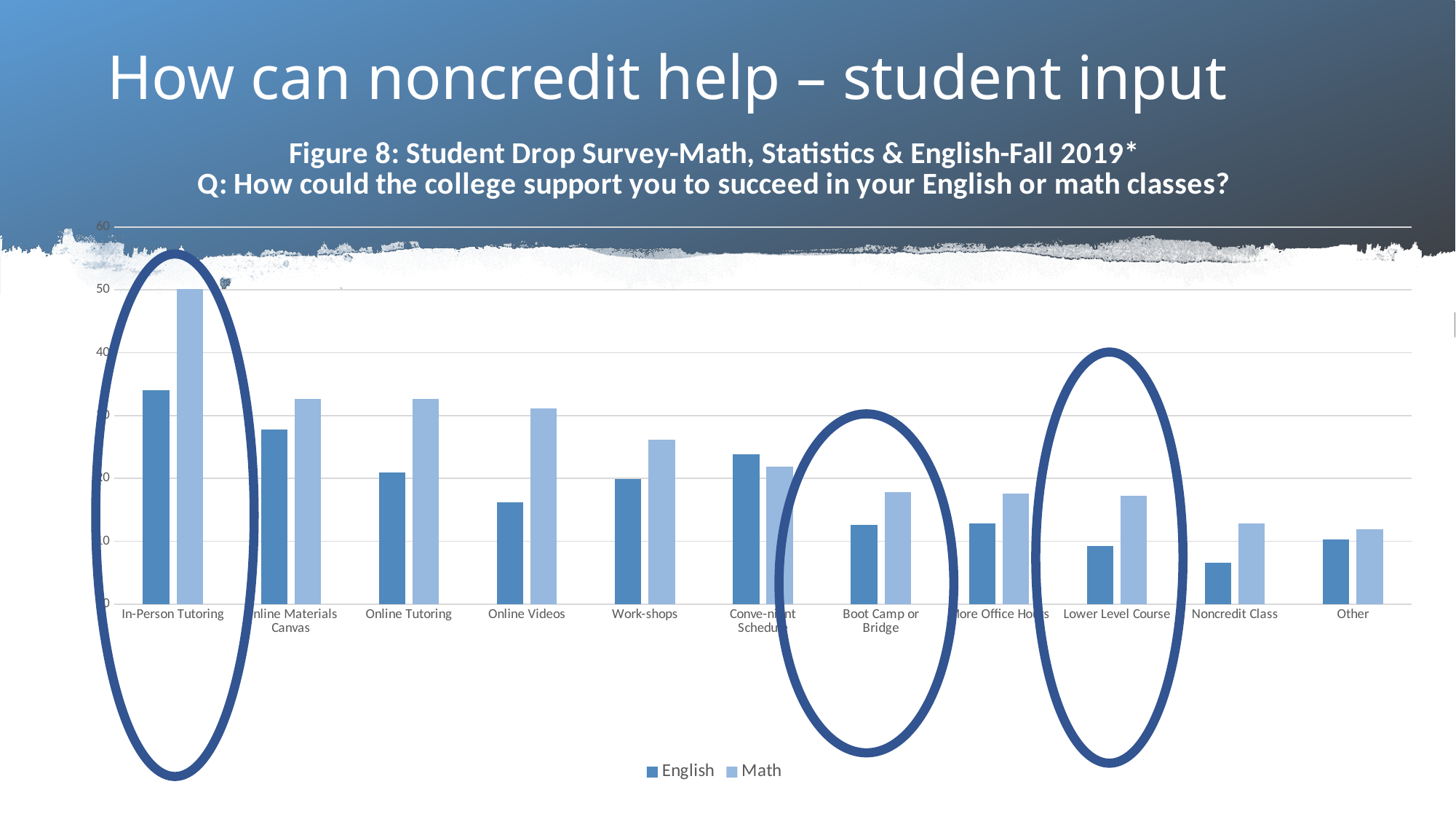
How many series does the legend list? 2 For Online Videos, which series has the larger value, English or Math? Math Is the Math value for Online Tutoring greater or less than 30? greater Which category has the lowest English value? Noncredit Class Is the Math value for Boot Camp or Bridge greater or less than 20? less What kind of chart is shown on the slide? bar chart Which series is shown in the darker blue colour in the legend? English How many categories are shown on the x axis? 11 For In-Person Tutoring, which series has the larger value, English or Math? Math Which category has the highest Math value? In-Person Tutoring Is the English value for Online Videos greater or less than 20? less Which category has the highest English value? In-Person Tutoring